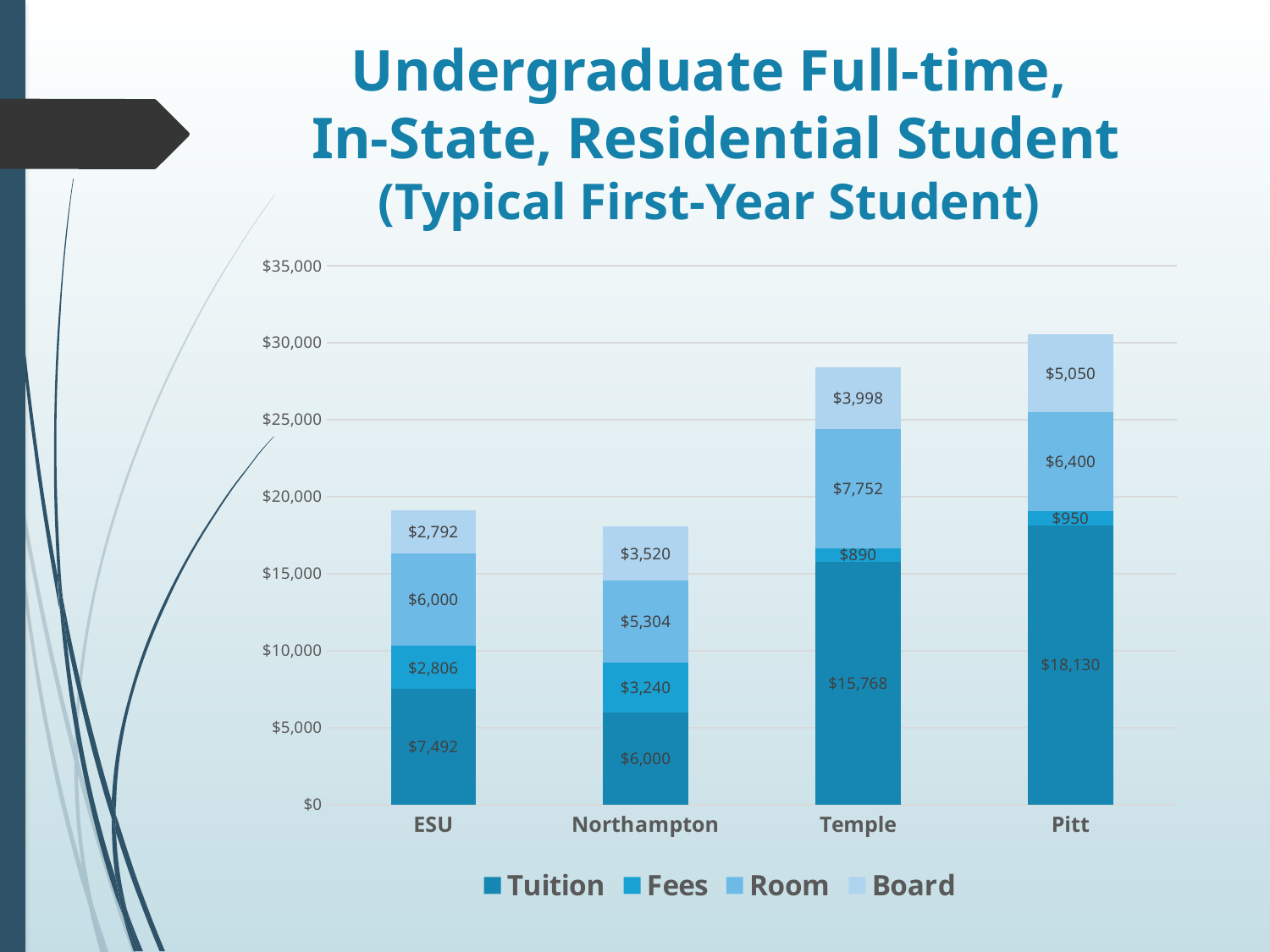
What is the difference between the Room values for Temple and ESU? $1,752 How many series does the legend list? 4 What is the Tuition value for Temple? $15,768 Which school has the lowest Fees? Temple What is the Fees value for Pitt? $950 Which is larger, the Board value for Pitt or the Board value for Temple? Pitt Which school has the highest Tuition? Pitt How many schools are shown on the x axis? 4 What is the total of the stacked bar for Pitt? $30,530 What kind of chart is shown on the slide? Stacked bar chart What is the Board value for Northampton? $3,520 What is the total of the stacked bar for ESU? $19,090